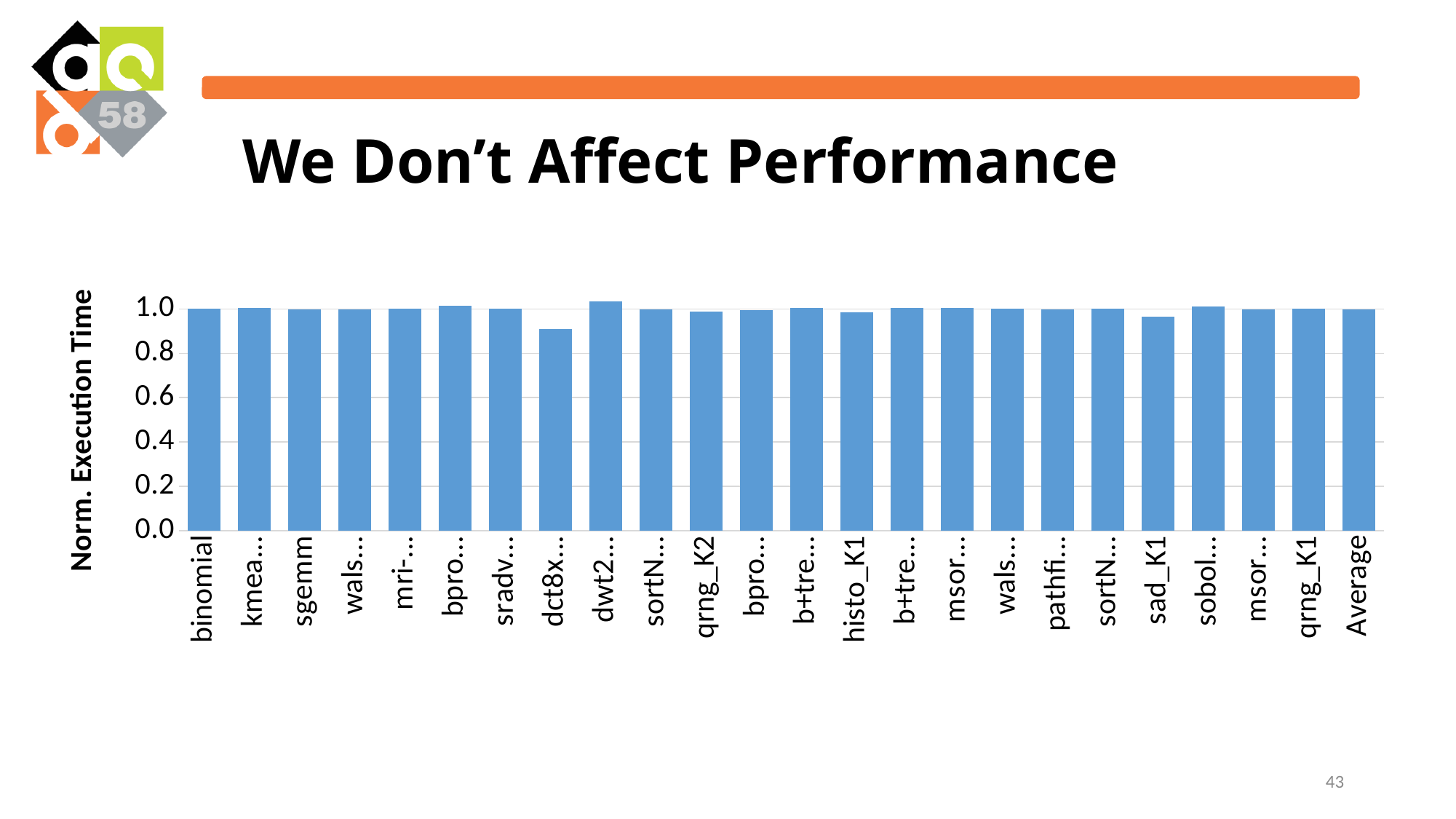
How many bars (categories) are plotted in the chart? 24 What is the label of the vertical axis? Norm. Execution Time Which has the larger normalized execution time, dct8x or sad_K1? sad_K1 Which category has the highest normalized execution time? dwt2 What kind of chart is shown on the slide? bar chart Is the value for dct8x greater or less than 0.8? greater Which category has the lowest normalized execution time? dct8x Is the value for sad_K1 greater or less than 1.0? less What is the title of the slide containing the chart? We Don't Affect Performance Is the value for dct8x greater or less than 1.0? less Which has the larger normalized execution time, dwt2 or dct8x? dwt2